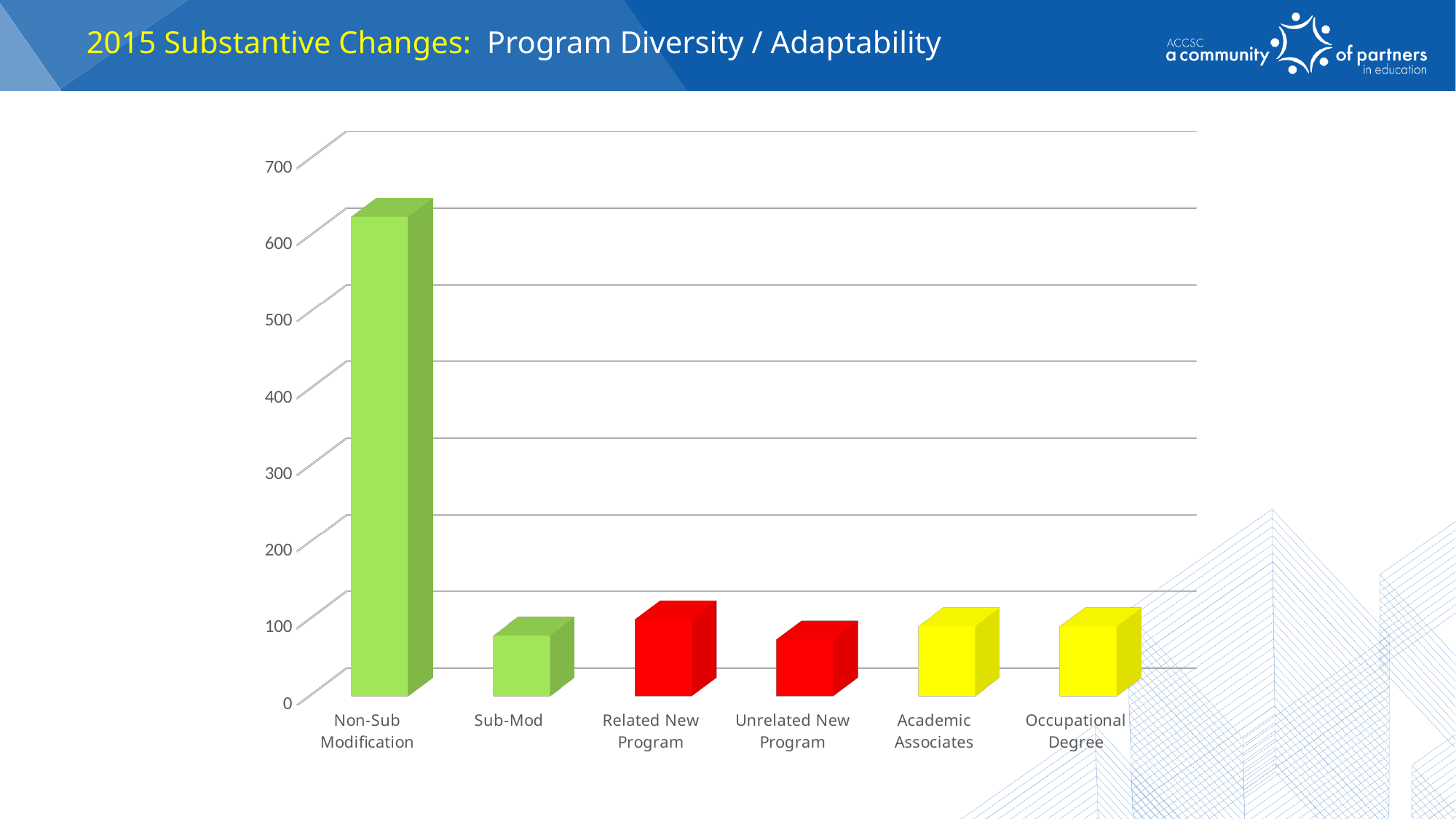
Is the value for Academic Associates greater or less than 300? less What colour are the bars for Related New Program and Unrelated New Program? Red Is the value for Related New Program greater or less than 200? less Which is larger, the value for Related New Program or the value for Unrelated New Program? Related New Program How many categories are shown on the x axis of the chart? 6 What kind of chart is shown on the slide? Bar chart Which category has the highest value in the chart? Non-Sub Modification Is the value for Non-Sub Modification greater or less than 700? less Which is larger, the value for Non-Sub Modification or the value for Sub-Mod? Non-Sub Modification What is the highest value labelled on the vertical axis of the chart? 700